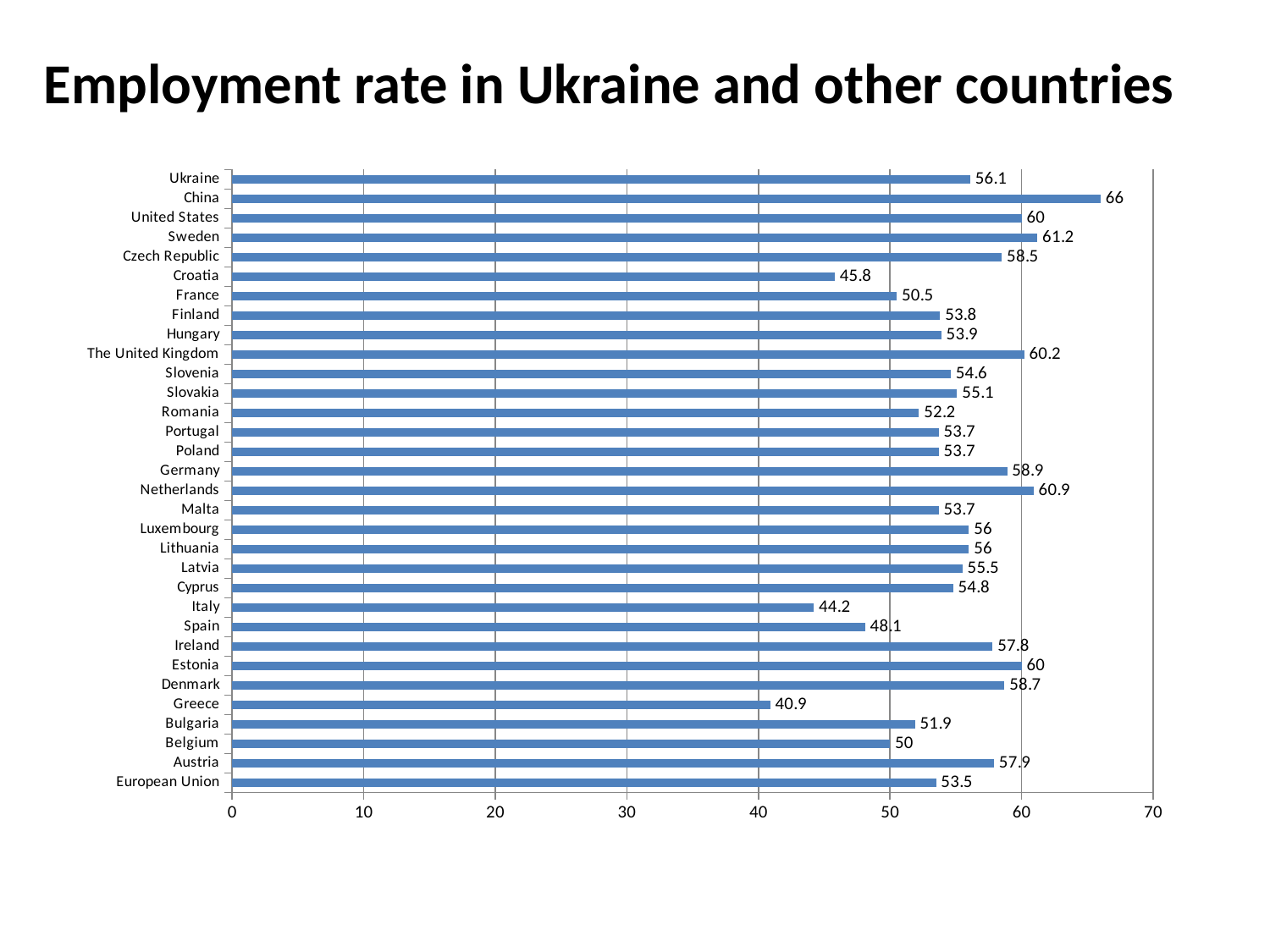
What is the value shown for the Netherlands? 60.9 Which country has the lowest employment rate on the chart? Greece What is the difference between the values for Sweden and Croatia? 15.4 What is the difference between the values for China and Ukraine? 9.9 What is the employment rate shown for Ukraine? 56.1 What is the value shown for the European Union? 53.5 What kind of chart is shown on the slide? bar chart Which country has the highest employment rate on the chart? China Is the value for Italy greater or less than 50? less How many countries or regions are shown on the chart? 32 What is the title of the slide? Employment rate in Ukraine and other countries Which has a higher employment rate, Germany or Denmark? Germany